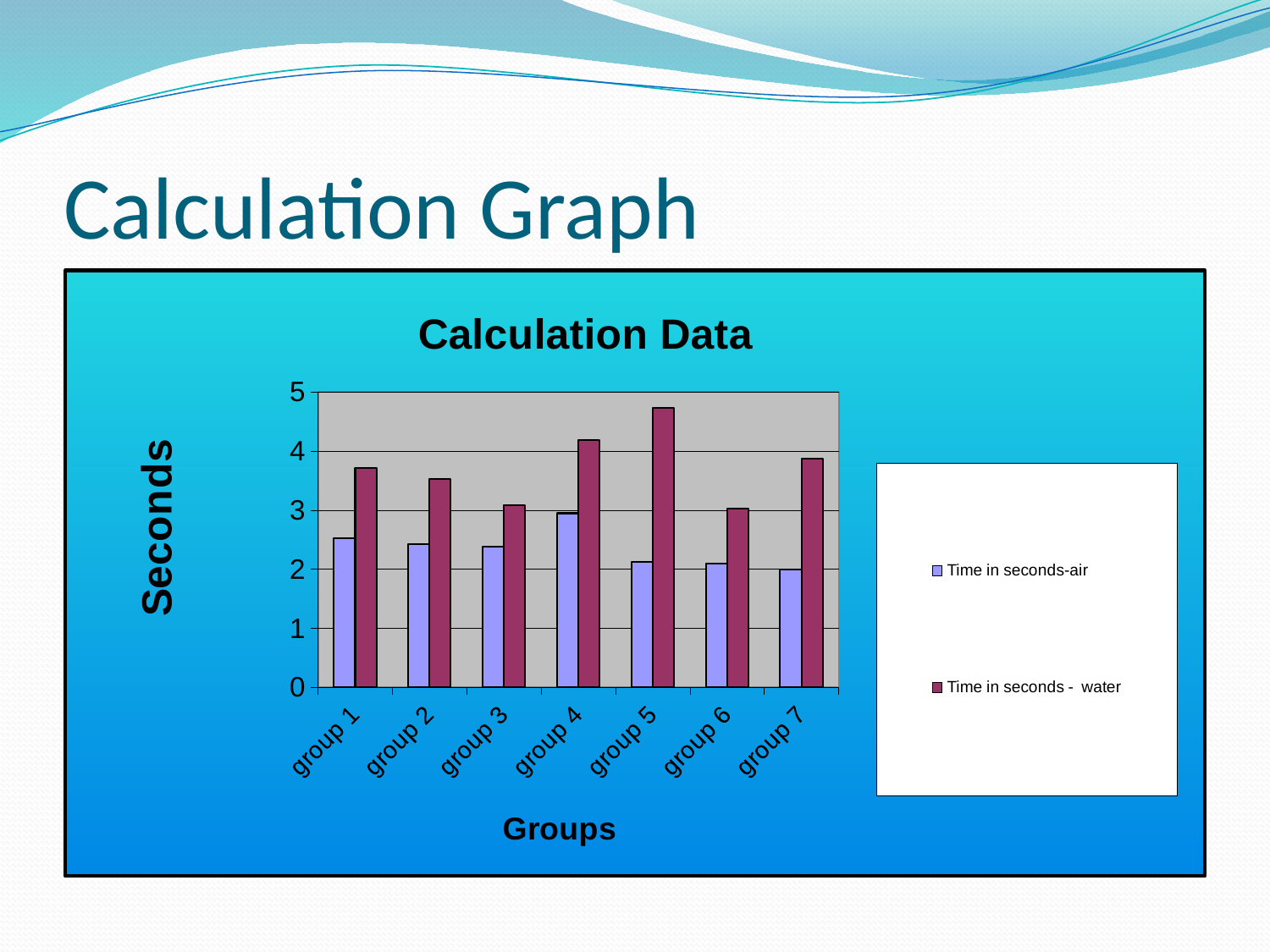
How many groups are shown on the x axis? 7 Which group has the highest value for Time in seconds - water? group 5 How many series does the legend list? 2 Is the Time in seconds - water value for group 5 greater or less than 4? greater What is the title of the chart? Calculation Data Which group has the highest value for Time in seconds-air? group 4 What kind of chart is shown on the slide? bar chart What is the label on the y axis of the chart? Seconds Is the Time in seconds-air value for group 7 greater or less than 3? less For group 4, which is larger: Time in seconds-air or Time in seconds - water? Time in seconds - water Is the Time in seconds - water value for group 1 greater or less than 3? greater